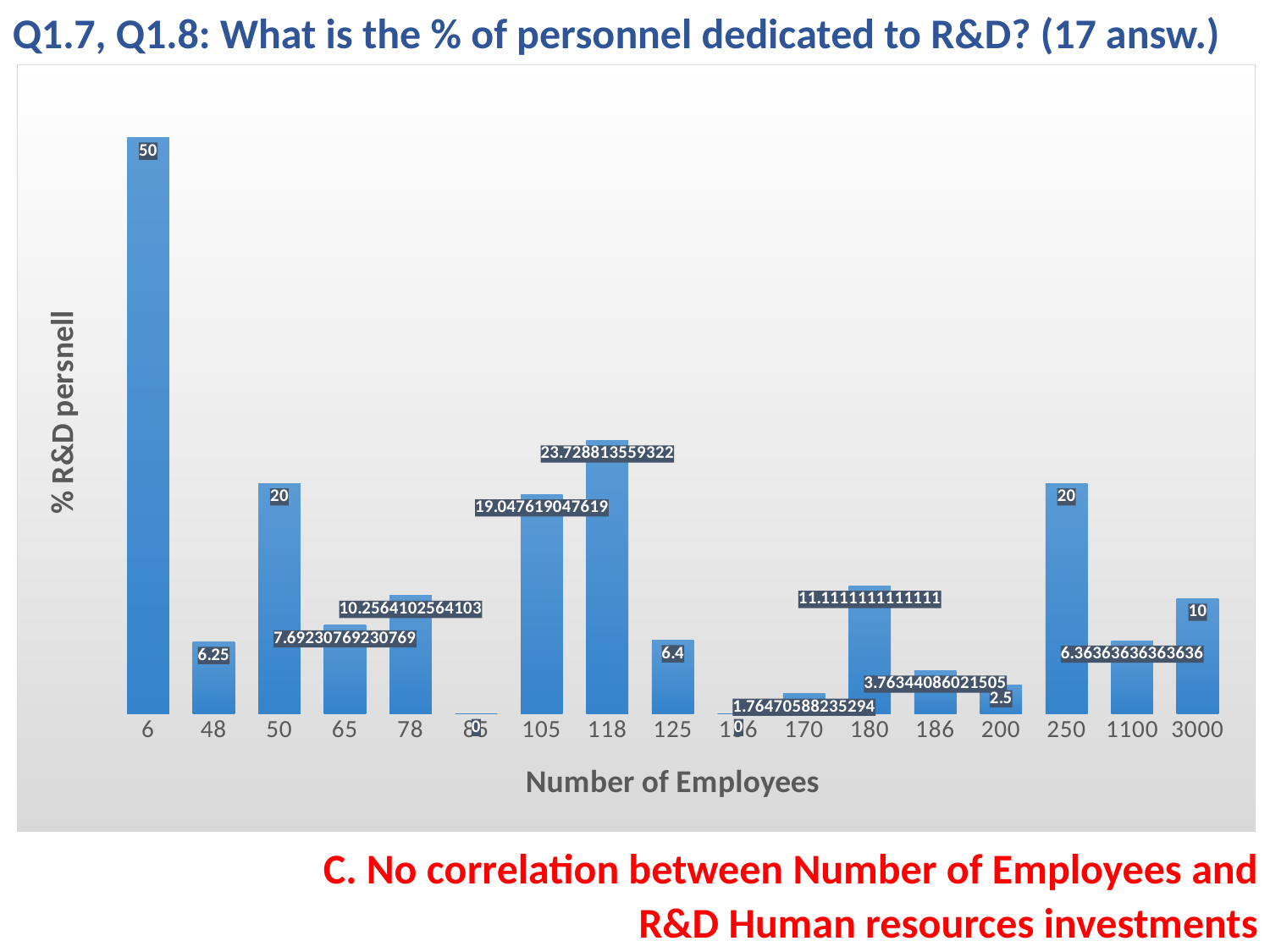
What is the % of R&D personnel for the company with 200 employees? 2.5 What is the difference in % R&D personnel between the company with 250 employees and the company with 3000 employees? 10 What is the % of R&D personnel for the company with 6 employees? 50 Which number of employees has the highest % of R&D personnel? 6 What is the % of R&D personnel for the company with 3000 employees? 10 How many categories (companies) are shown on the x axis of the chart? 17 What is the difference in % R&D personnel between the company with 6 employees and the company with 50 employees? 30 What is the % of R&D personnel for the company with 118 employees? 23.728813559322 What is the % of R&D personnel for the company with 48 employees? 6.25 Which has a higher % of R&D personnel: the company with 105 employees or the company with 118 employees? 118 What kind of chart is shown on the slide? Bar chart Which has a higher % of R&D personnel: the company with 170 employees or the company with 186 employees? 186